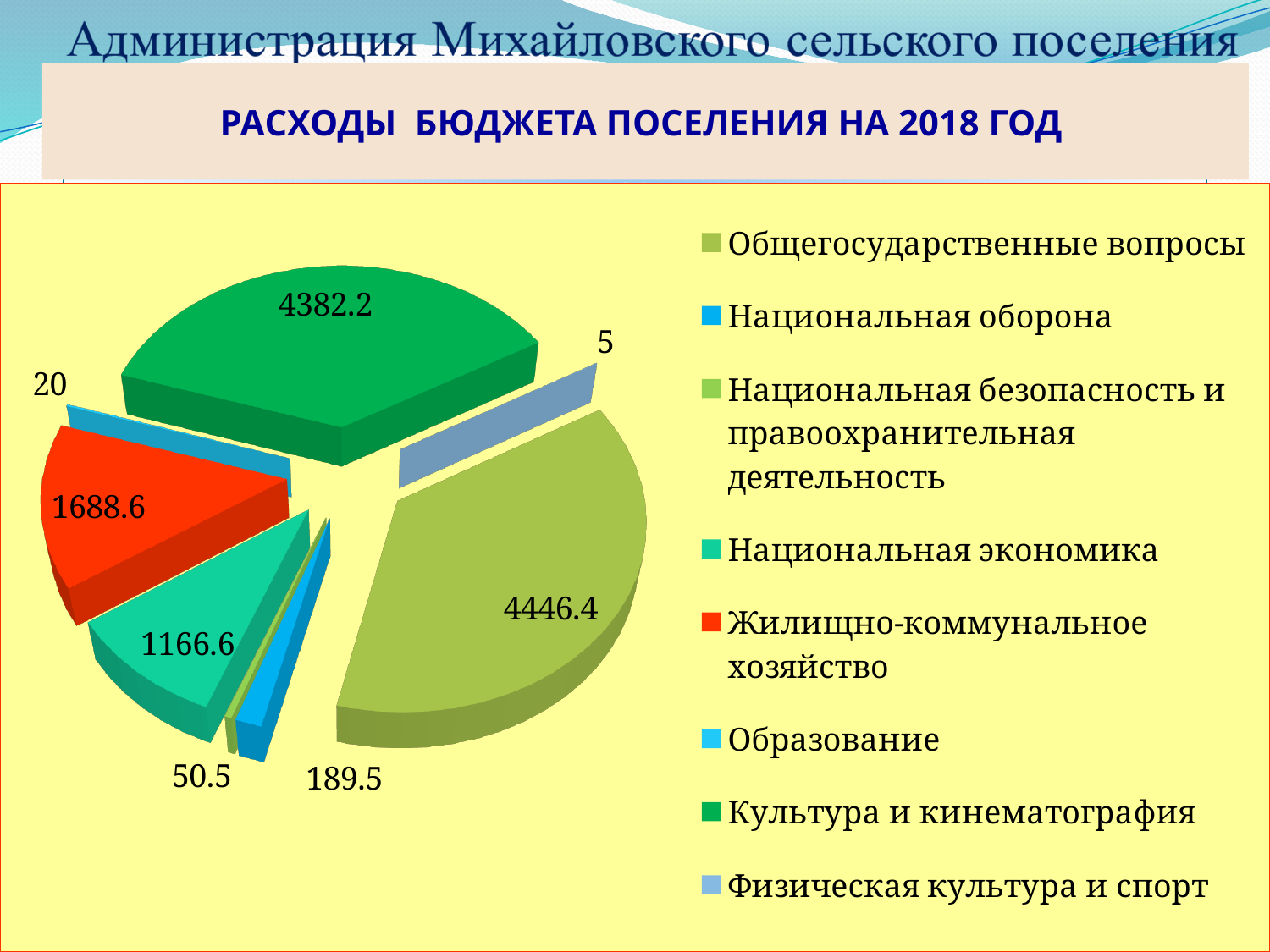
What is the difference between the values for Общегосударственные вопросы and Культура и кинематография? 64.2 What is the value for Национальная оборона? 189.5 What is the value for Общегосударственные вопросы? 4446.4 How many categories does the legend of the pie chart list? 8 What is the value for Жилищно-коммунальное хозяйство? 1688.6 Which is larger: the value for Жилищно-коммунальное хозяйство or the value for Национальная экономика? Жилищно-коммунальное хозяйство What is the value for Национальная экономика? 1166.6 What is the title of the chart on the slide? РАСХОДЫ БЮДЖЕТА ПОСЕЛЕНИЯ НА 2018 ГОД What is the value for Культура и кинематография? 4382.2 Which category has the largest value in the pie chart? Общегосударственные вопросы What type of chart is shown on the slide? Pie chart Which category has the smallest value in the pie chart? Физическая культура и спорт